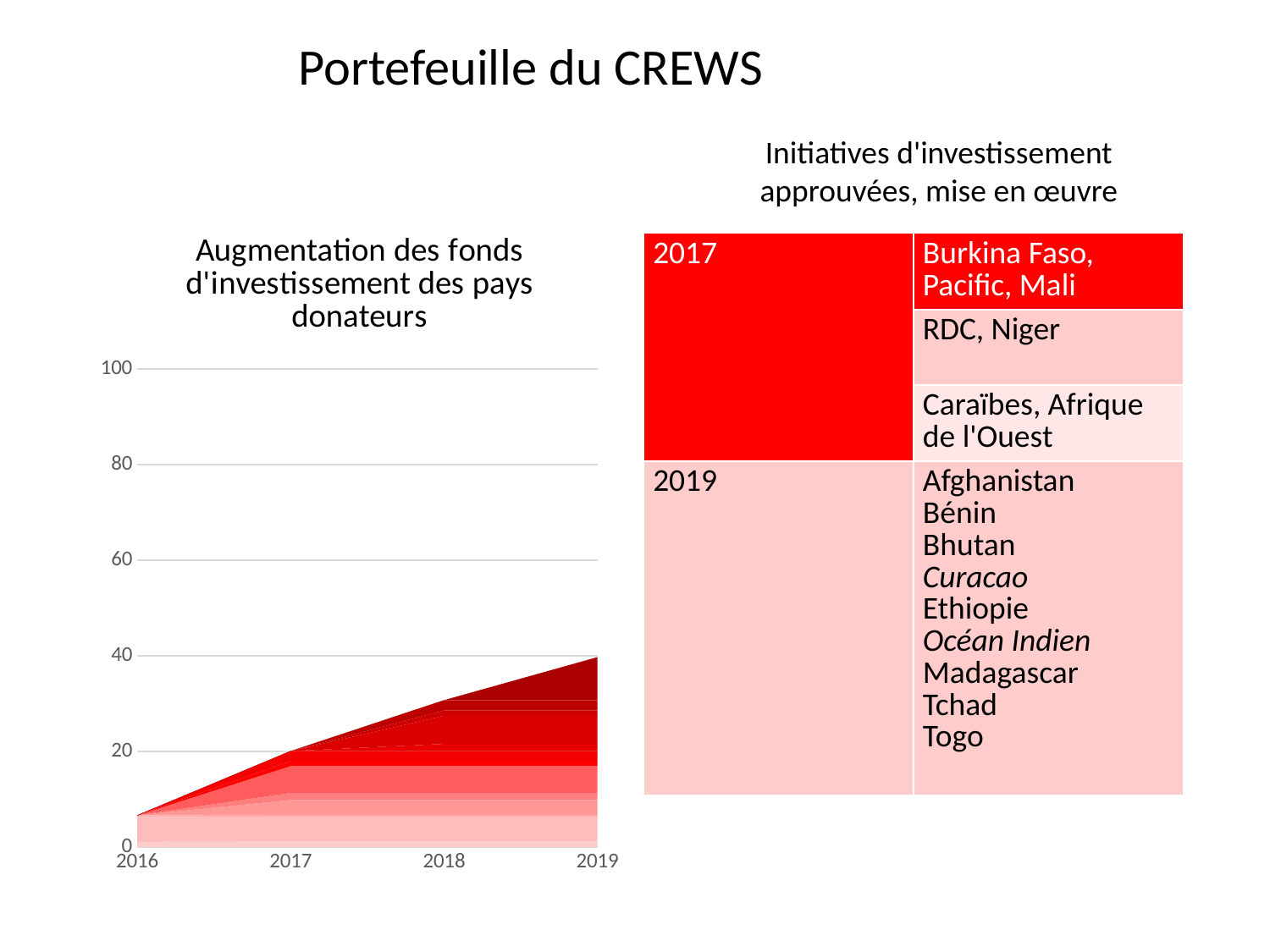
What kind of chart is shown under the title "Augmentation des fonds d'investissement des pays donateurs"? Stacked area chart What is the highest value shown on the y axis of the chart "Augmentation des fonds d'investissement des pays donateurs"? 100 In the chart "Augmentation des fonds d'investissement des pays donateurs", do the total values rise or fall from 2016 to 2019? Rise In the chart "Augmentation des fonds d'investissement des pays donateurs", is the total value for 2018 greater or less than 40? less In the chart "Augmentation des fonds d'investissement des pays donateurs", which year has the larger total value, 2016 or 2018? 2018 In the chart "Augmentation des fonds d'investissement des pays donateurs", which year has the lowest total value? 2016 In the chart "Augmentation des fonds d'investissement des pays donateurs", is the total value for 2019 greater or less than 60? less What is the first year shown on the x axis of the chart "Augmentation des fonds d'investissement des pays donateurs"? 2016 In the chart "Augmentation des fonds d'investissement des pays donateurs", is the total value for 2018 greater or less than 20? greater In the chart "Augmentation des fonds d'investissement des pays donateurs", which year has the highest total value? 2019 How many years are shown on the x axis of the chart "Augmentation des fonds d'investissement des pays donateurs"? 4